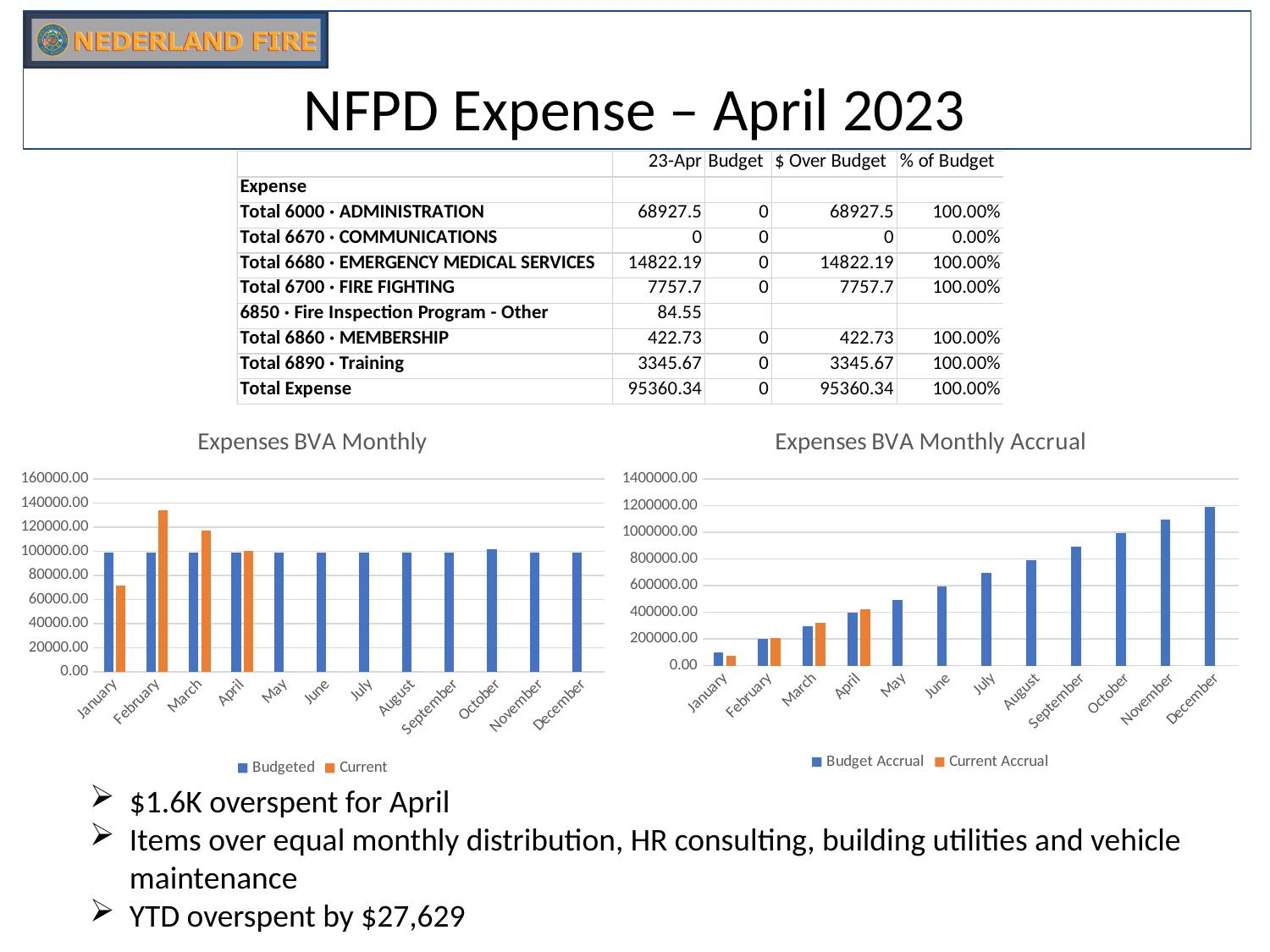
In the 'Expenses BVA Monthly Accrual' chart, do the Budget Accrual values rise or fall from January to December? rise In the 'Expenses BVA Monthly' chart, which month has the lowest Current bar? January In the 'Expenses BVA Monthly Accrual' chart, is the Budget Accrual value for December greater or less than 1000000? greater In the 'Expenses BVA Monthly' chart, how many series does the legend list? 2 In the 'Expenses BVA Monthly Accrual' chart, is the Current Accrual value for March greater or less than 200000? greater In the 'Expenses BVA Monthly' chart, how many months are shown on the x axis? 12 What kind of chart is the 'Expenses BVA Monthly' chart? bar chart What are the two legend entries in the 'Expenses BVA Monthly Accrual' chart? Budget Accrual and Current Accrual In the 'Expenses BVA Monthly' chart, is the Current value for January greater or less than 80000? less In the 'Expenses BVA Monthly' chart, which is larger for March, the Budgeted bar or the Current bar? Current In the 'Expenses BVA Monthly' chart, which month has the highest Current bar? February